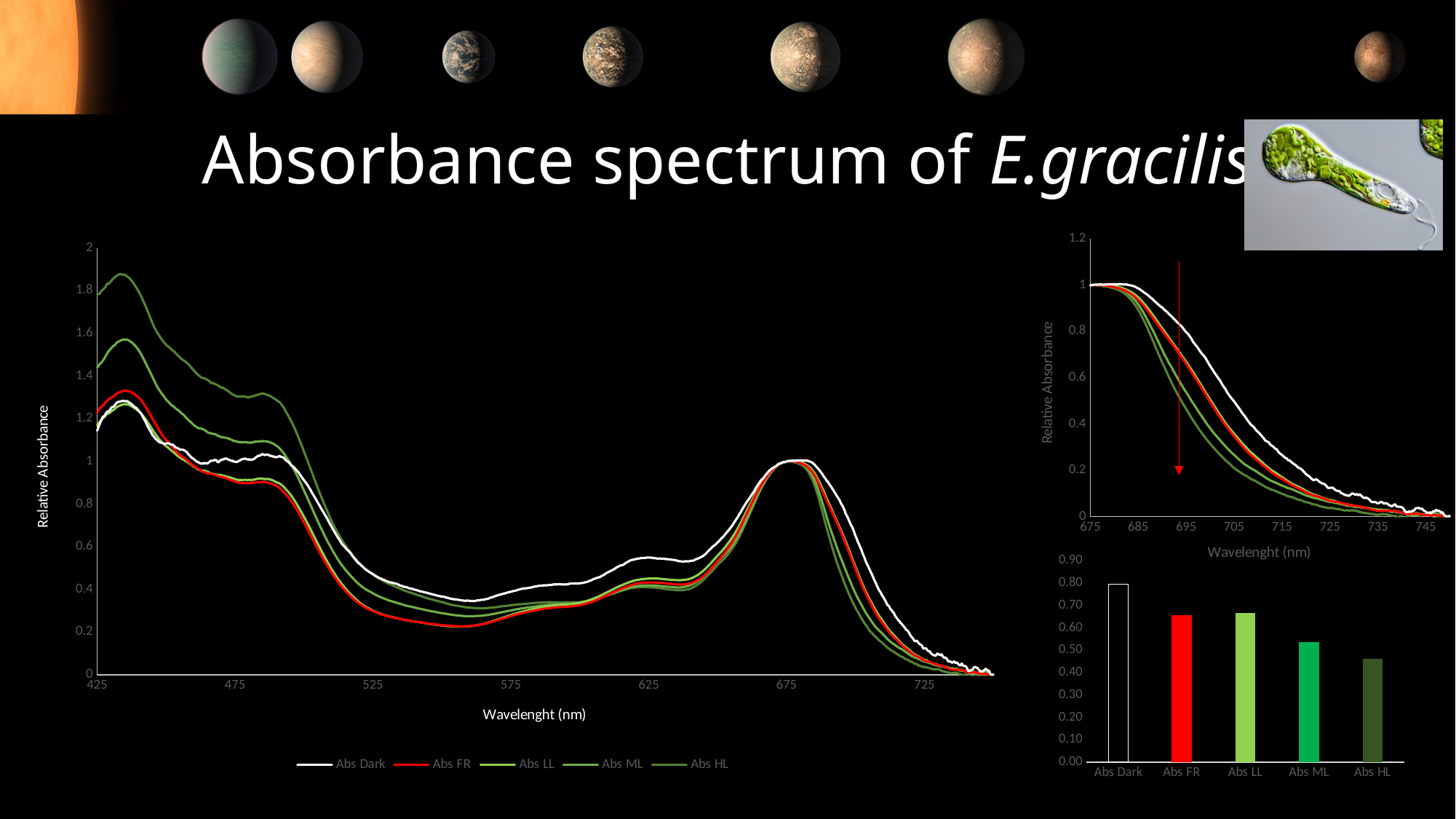
In the bottom-right bar chart, is the value for Abs HL greater or less than 0.50? less In the bottom-right bar chart, is the value for Abs ML greater or less than 0.60? less What kind of chart is the large chart on the left of the slide? line chart In the bottom-right bar chart, is the value for Abs Dark greater or less than 0.70? greater In the bottom-right bar chart, how many bars are there? 5 In the bottom-right bar chart, which is larger, the value for Abs Dark or the value for Abs ML? Abs Dark In the bottom-right bar chart, which category has the highest bar? Abs Dark In the large line chart on the left, do the values rise or fall between 475 nm and 525 nm? fall In the large line chart on the left, what is the label of the x axis? Wavelenght (nm) What kind of chart is the chart in the bottom-right corner of the slide? bar chart In the bottom-right bar chart, which category has the lowest bar? Abs HL In the large line chart on the left, how many series does the legend list? 5